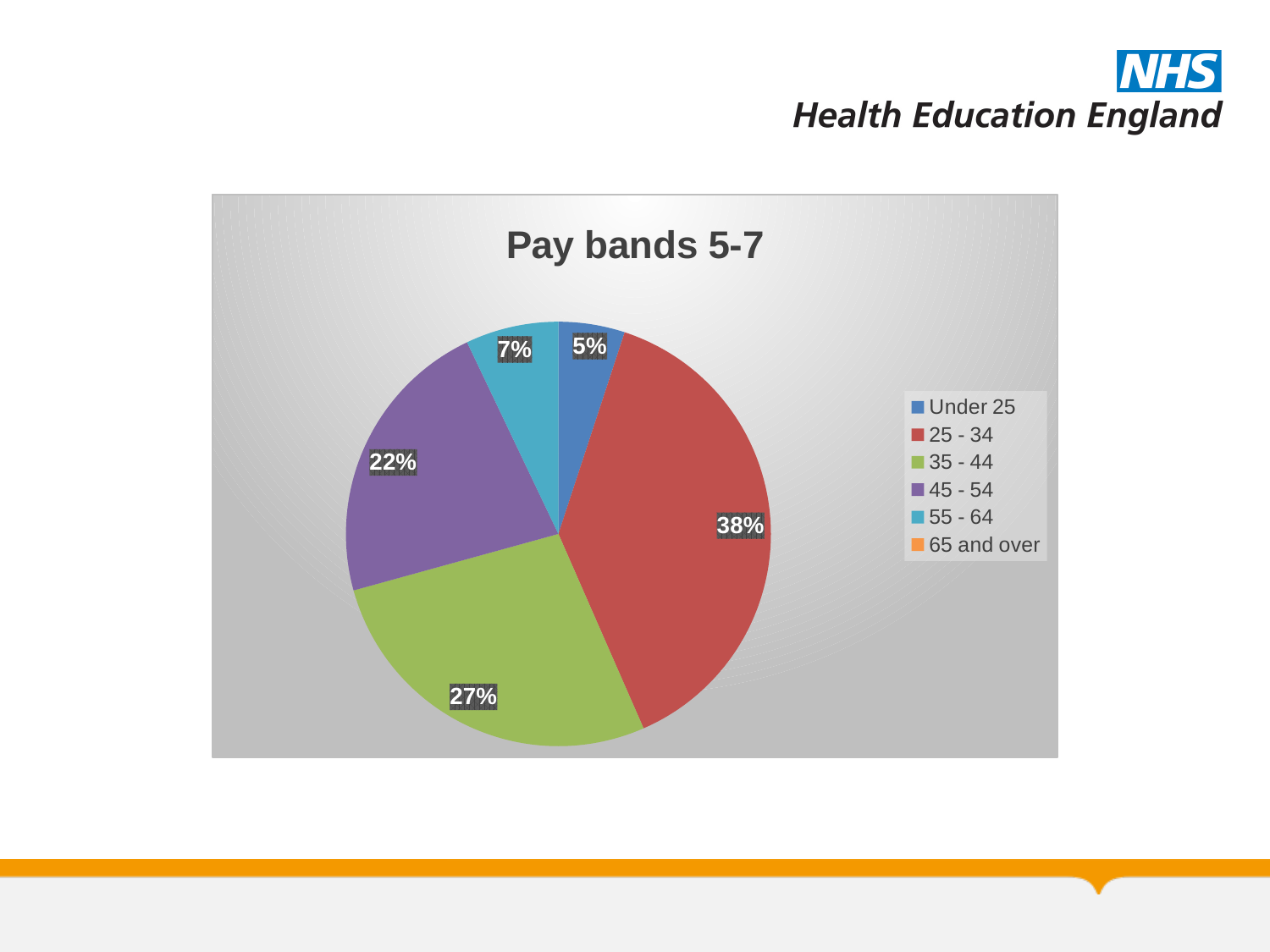
Which age group has the largest share of the pie? 25 - 34 How many entries does the legend list? 6 What share of the pie does the 35 - 44 age group have? 27% What share of the pie does the 45 - 54 age group have? 22% What is the difference between the shares of the 25 - 34 and 35 - 44 age groups? 11% What share of the pie does the Under 25 age group have? 5% What type of chart is shown on the slide? pie chart What is the title of the pie chart? Pay bands 5-7 Which has a larger share, the 45 - 54 group or the 55 - 64 group? 45 - 54 Which of the labelled slices has the smallest share of the pie? Under 25